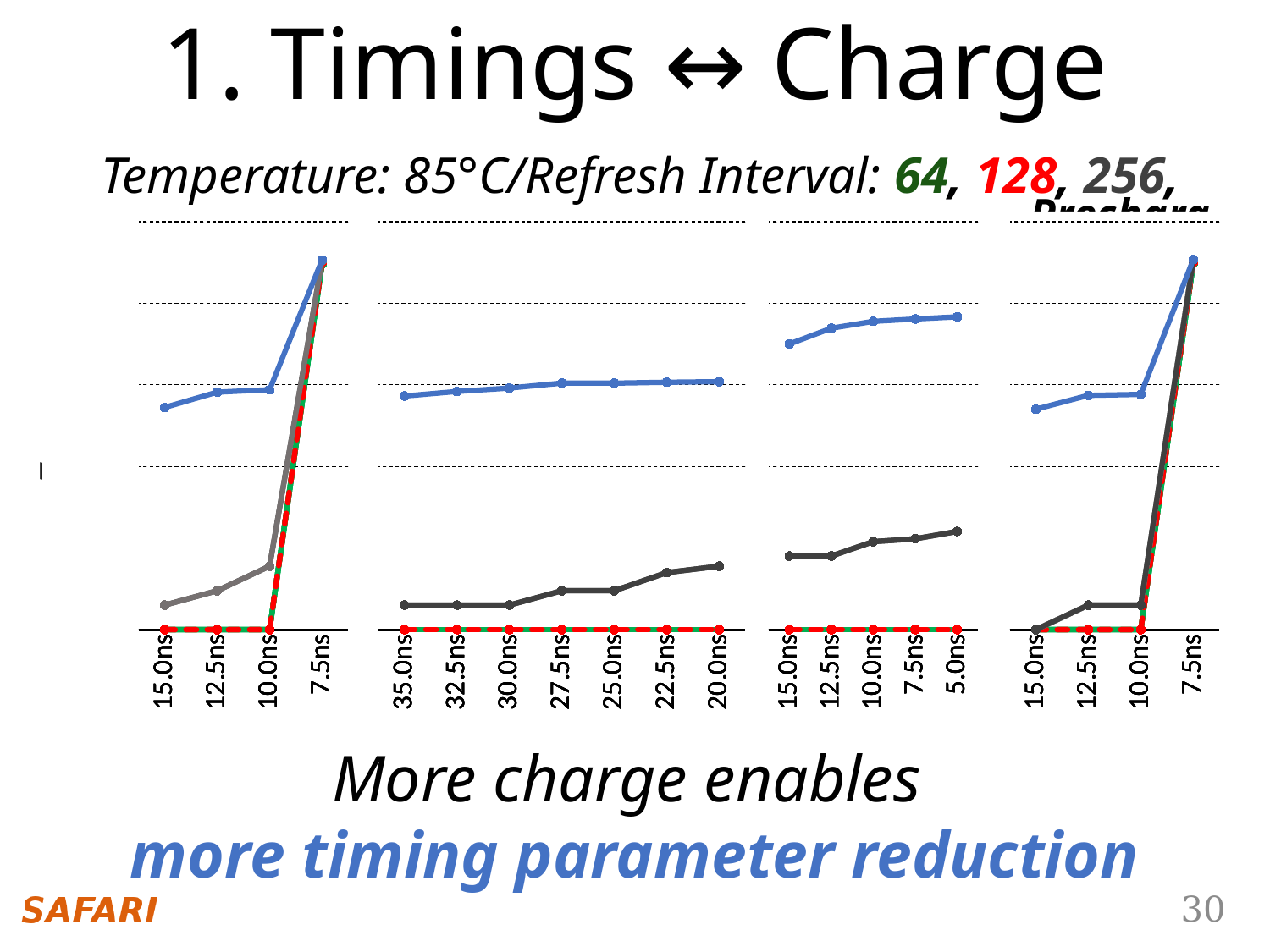
How many x-axis categories does the third chart from the left have? 5 In the third chart from the left, does the blue line rise or fall from left to right along the x axis? rises How many x-axis categories does the rightmost chart have? 4 In the third chart from the left, what is the rightmost x-axis label? 5.0ns How many x-axis categories does the leftmost chart have? 4 In the second chart from the left, does the blue line rise or fall from left to right along the x axis? rises In the second chart from the left, what is the leftmost x-axis label? 35.0ns In the second chart from the left, which coloured line is the highest across all x-axis points? blue In the rightmost chart, at which x-axis label do the blue and dark lines reach their highest point? 7.5ns What kind of chart is used in each of the four panels on the slide? line chart In the leftmost chart, at 15.0ns, is the blue line higher or lower than the gray line? higher